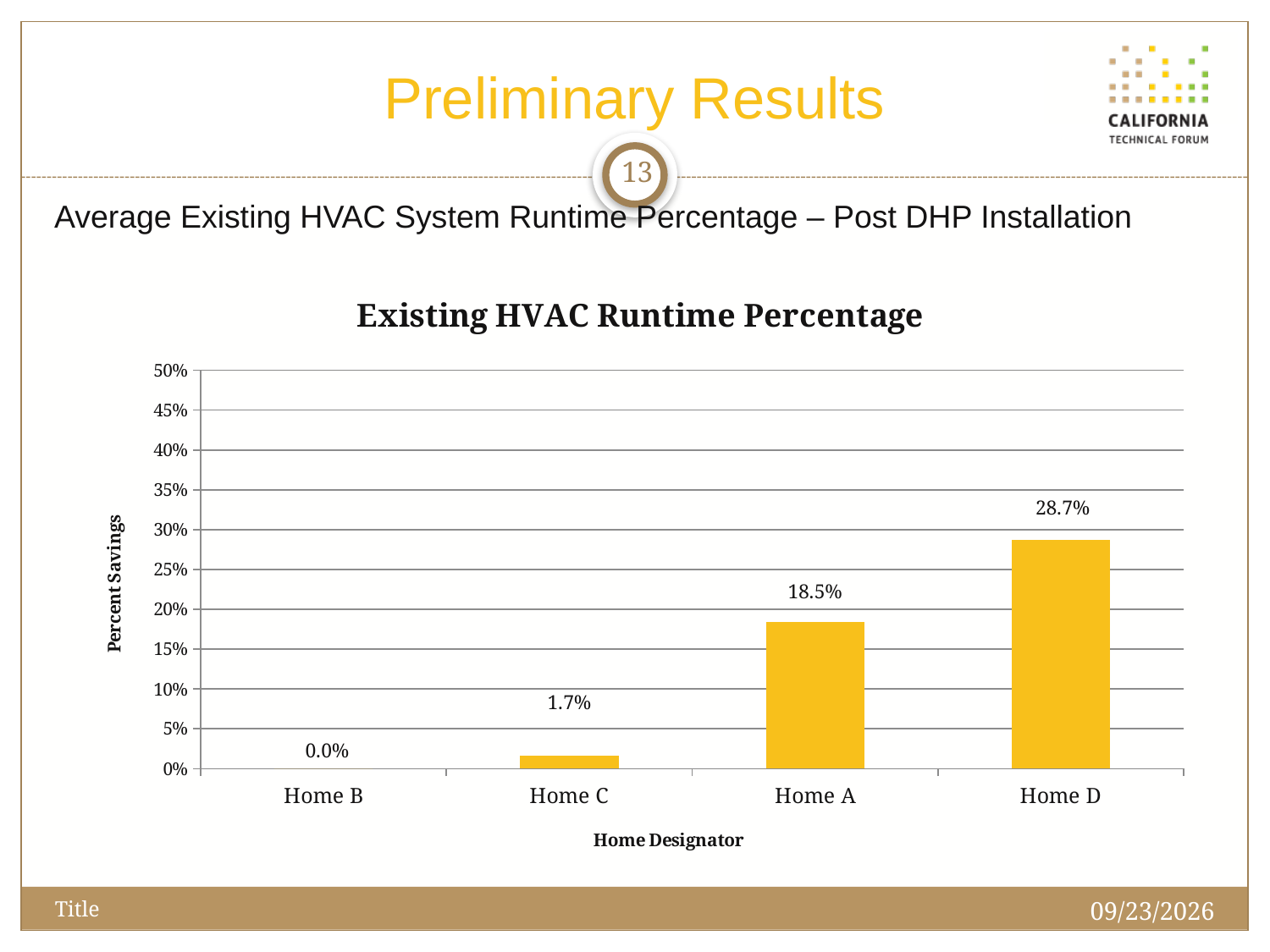
Which home has the lowest existing HVAC runtime percentage? Home B Which home has the highest existing HVAC runtime percentage? Home D What is the difference between the values for Home D and Home A? 10.2% What is the title of the chart? Existing HVAC Runtime Percentage What is the value for Home C? 1.7% Which is larger, the value for Home C or the value for Home A? Home A Is the value for Home D greater or less than 25%? greater What is the value for Home D? 28.7% What kind of chart is shown on the slide? Bar chart How many homes are shown on the x axis? 4 What is the value for Home A? 18.5% What is the value for Home B? 0.0%